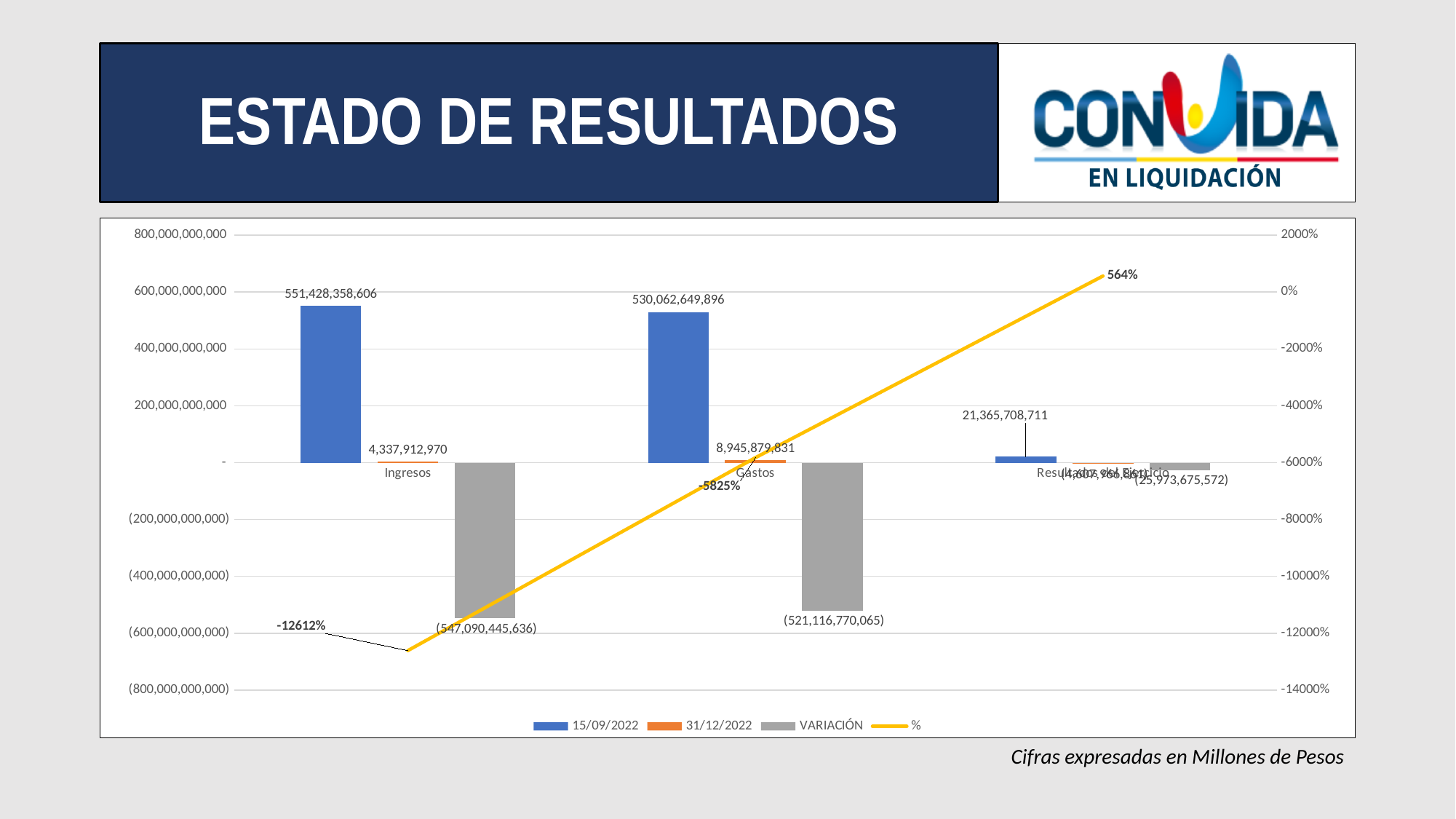
What is the % value for Resultado del Ejercicio? 564% What is the 15/09/2022 value for Ingresos? 551,428,358,606 What is the VARIACIÓN value for Ingresos? (547,090,445,636) What is the % value for Gastos? -5825% Does the % line rise or fall from Ingresos to Resultado del Ejercicio? rise What is the difference between the 15/09/2022 values for Ingresos and Gastos? 21,365,708,710 Which has the larger 31/12/2022 value, Ingresos or Gastos? Gastos How many series does the legend list? 4 How many categories are shown on the x axis? 3 Which category has the highest 15/09/2022 value? Ingresos What is the 31/12/2022 value for Gastos? 8,945,879,831 What kind of chart is shown on the slide? bar chart with a line